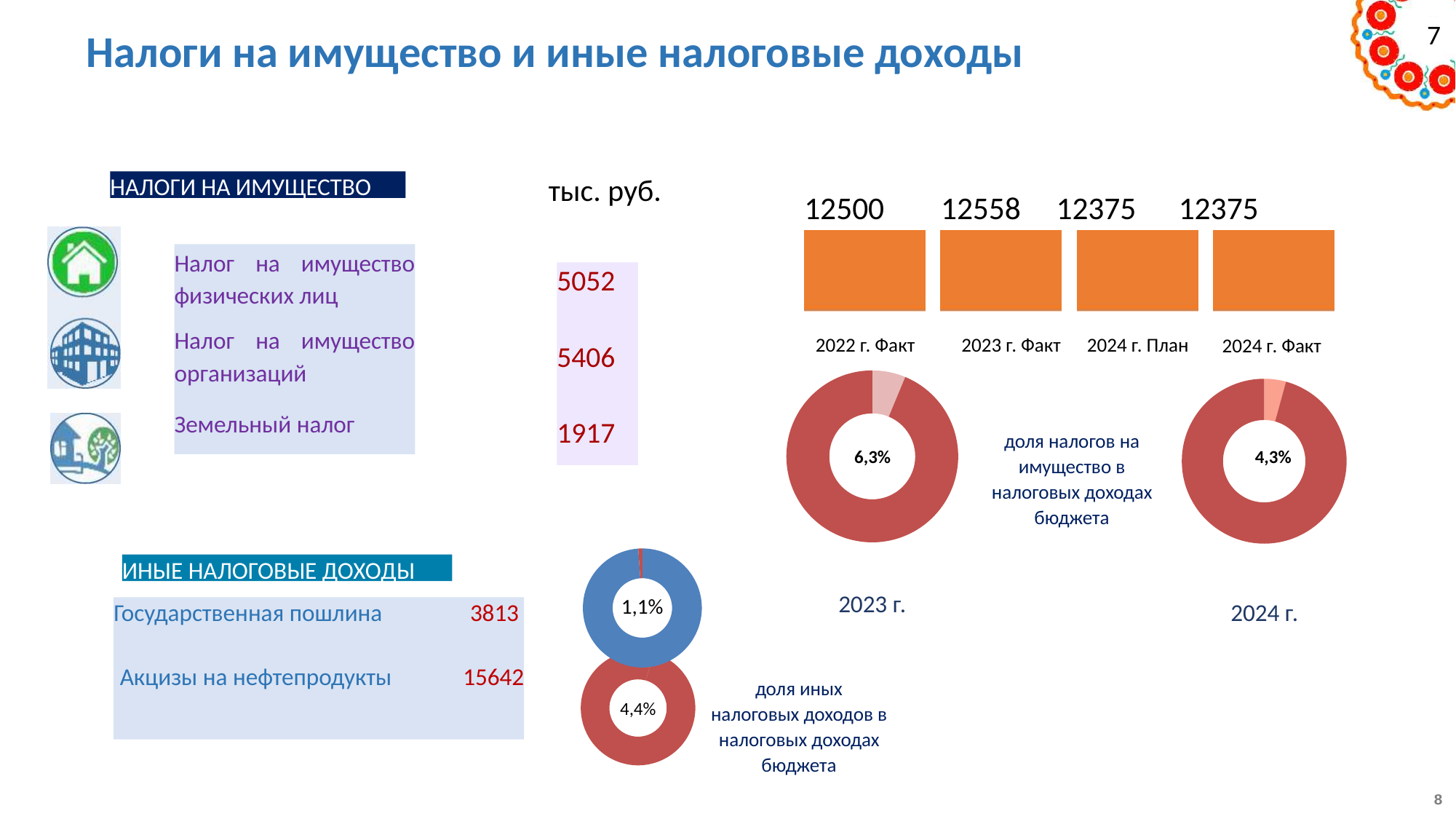
In the donut chart for 2024 г., what share of budget tax revenues do property taxes make up? 4,3% Which year's donut chart shows a larger share of property taxes in budget tax revenues, 2023 г. or 2024 г.? 2023 г. In the bar chart of property taxes, what is the value for 2023 г. Факт? 12558 In the red donut chart at the bottom left showing the share of other tax revenues, what percentage is shown? 4,4% In the bar chart of property taxes, which category has the highest value? 2023 г. Факт In the bar chart of property taxes, what is the difference between 2023 г. Факт and 2024 г. Факт? 183 In the bar chart of property taxes, what is the value for 2022 г. Факт? 12500 In the bar chart of property taxes, what is the difference between 2023 г. Факт and 2022 г. Факт? 58 What kind of chart shows the values 12500, 12558, 12375 and 12375? bar chart In the bar chart of property taxes, how many bars are shown? 4 In the donut chart for 2023 г., what share of budget tax revenues do property taxes make up? 6,3% In the bar chart of property taxes, what is the value for 2024 г. План? 12375